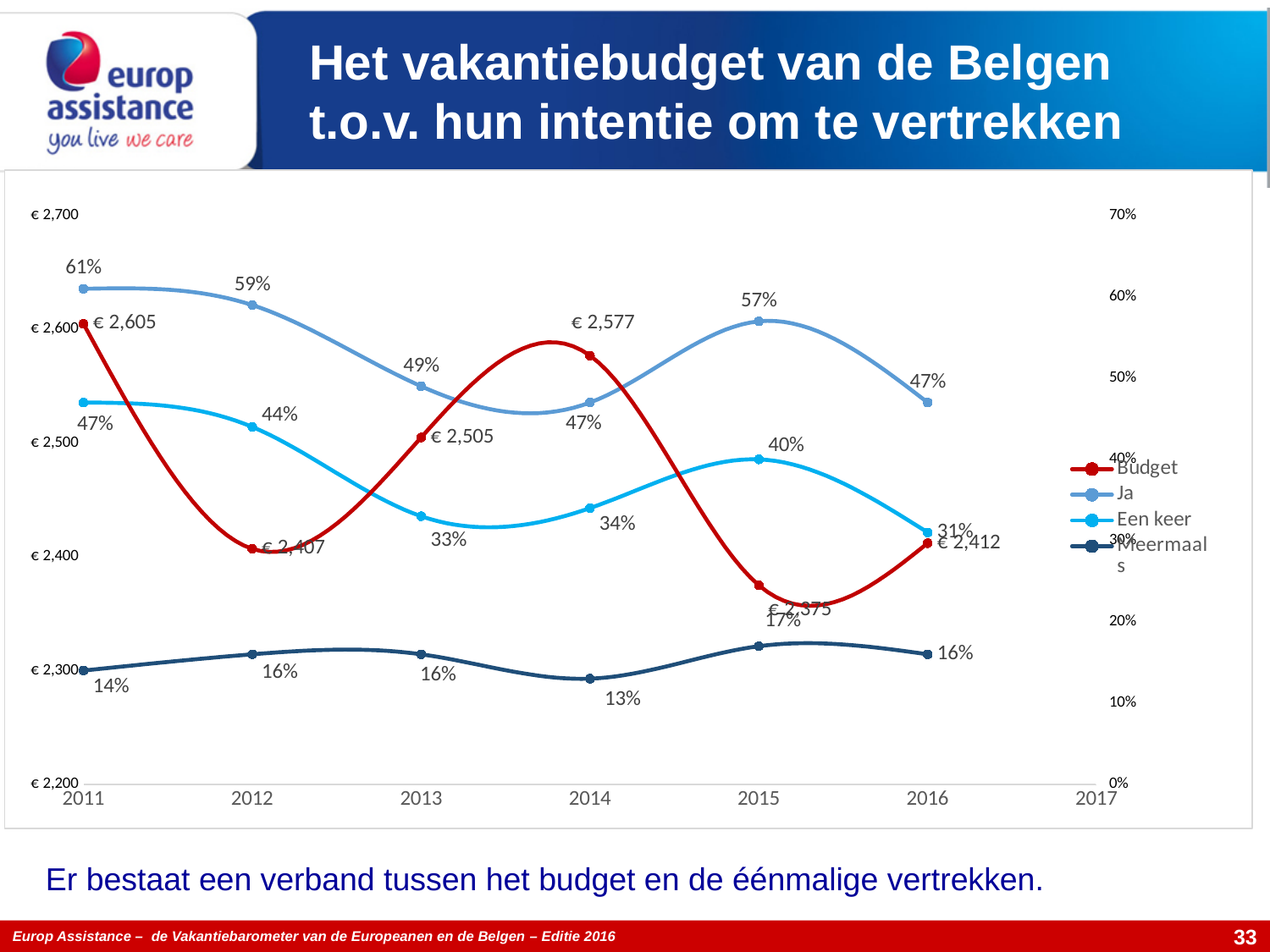
What type of chart is shown on the slide? line chart What is the Budget value for 2011? € 2,605 How many series does the legend list? 4 In which year is the Budget series lowest? 2015 In which year is the Ja series highest? 2011 What is the value of the Een keer series in 2013? 33% What is the difference between the Budget values for 2011 and 2012? € 198 What is the Budget value for 2014? € 2,577 What is the value of the Ja series in 2015? 57% Which is larger in 2016, the Ja value or the Een keer value? Ja What is the value of the Meermaals series in 2014? 13% Does the Een keer series rise or fall from 2011 to 2013? fall